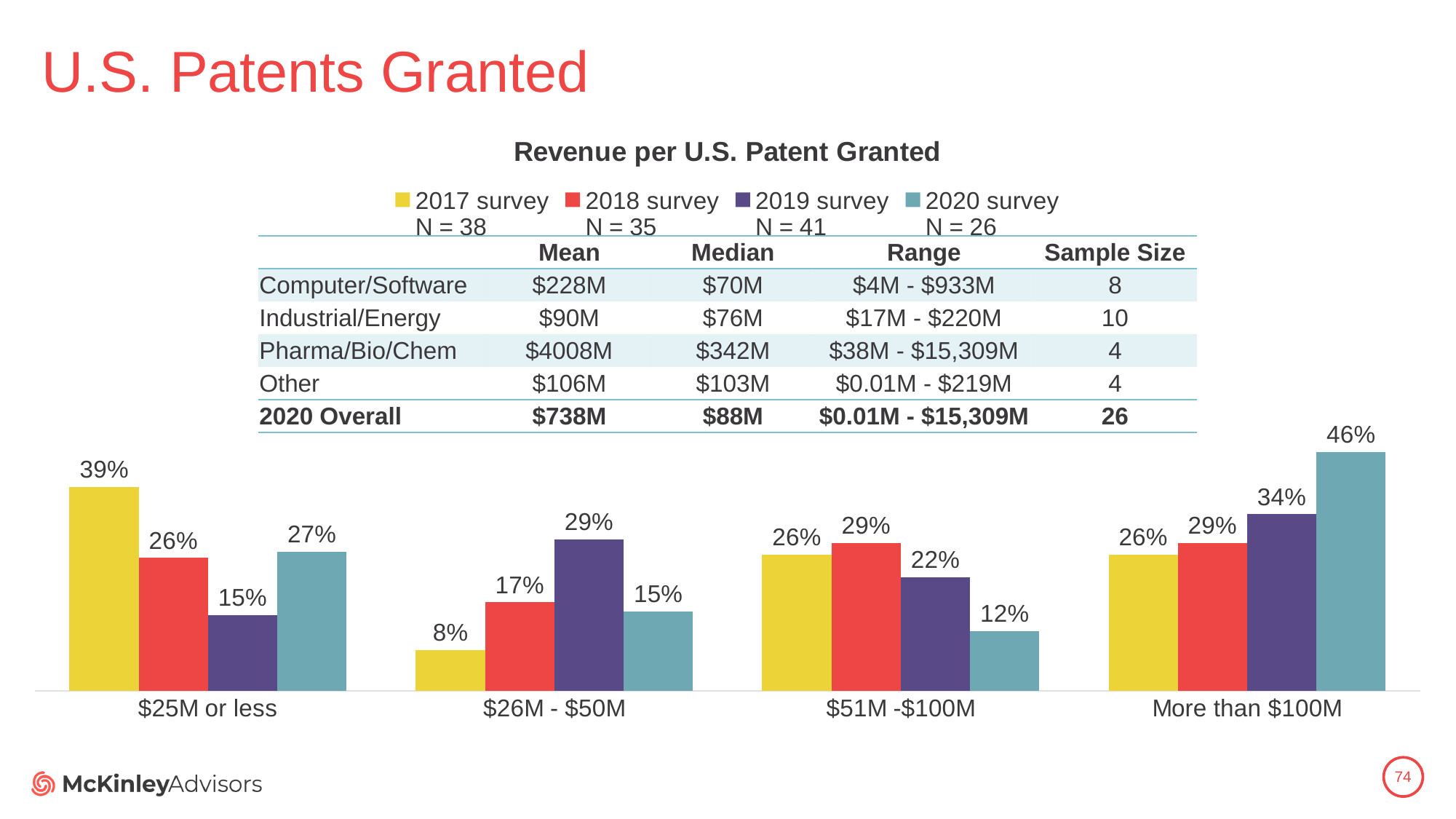
What type of chart is used to show Revenue per U.S. Patent Granted? Bar chart What is the sample size (N) for the 2019 survey shown in the legend? N = 41 What percentage of 2020 survey respondents reported revenue per U.S. patent granted of more than $100M? 46% What is the 2019 survey value for the $51M -$100M category? 22% In the $25M or less category, which is larger: the 2018 survey value or the 2020 survey value? 2020 survey Which category has the highest 2017 survey value? $25M or less What is the difference between the 2020 survey and 2017 survey values for the More than $100M category? 20% How many survey series does the chart legend list? 4 Which category has the lowest 2020 survey value? $51M -$100M Do the 2020 survey values rise or fall from the $51M -$100M category to the More than $100M category? Rise How many revenue categories are shown on the x axis of the chart? 4 What is the 2017 survey value for the $26M - $50M category? 8%